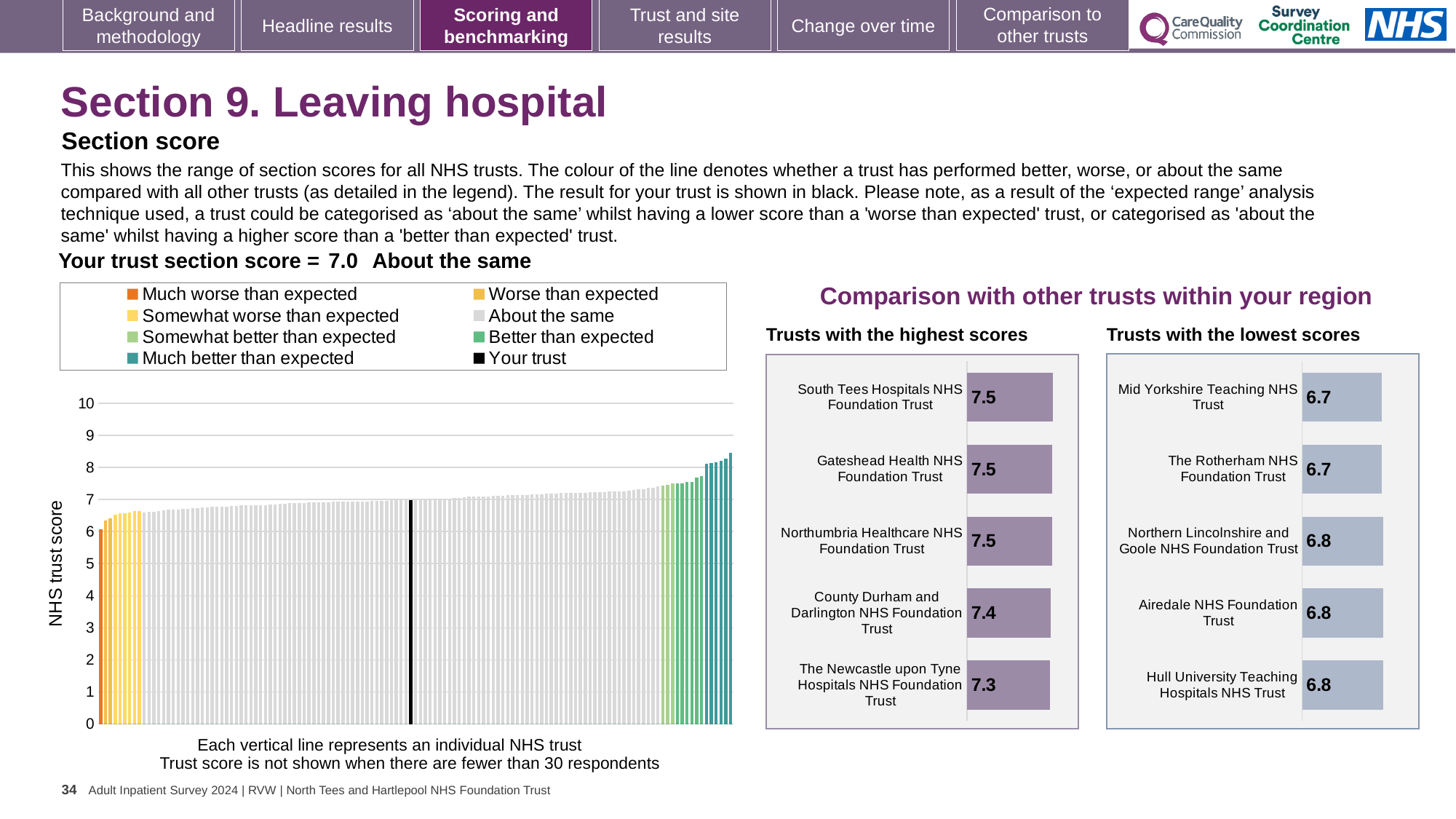
In the 'Trusts with the highest scores' chart, which trust has the lowest score? The Newcastle upon Tyne Hospitals NHS Foundation Trust In the 'Trusts with the lowest scores' chart, what is the score for Hull University Teaching Hospitals NHS Trust? 6.8 What kind of chart is the large chart on the left showing NHS trust scores? bar chart In the large chart on the left, is the value of the black bar (your trust) greater or less than 5? greater In the 'Trusts with the highest scores' chart, what is the score for South Tees Hospitals NHS Foundation Trust? 7.5 What is the label on the vertical axis of the large chart on the left? NHS trust score In the 'Trusts with the lowest scores' chart, what is the difference between the scores of Airedale NHS Foundation Trust and Mid Yorkshire Teaching NHS Trust? 0.1 In the 'Trusts with the highest scores' chart, which has the higher score: County Durham and Darlington NHS Foundation Trust or The Newcastle upon Tyne Hospitals NHS Foundation Trust? County Durham and Darlington NHS Foundation Trust In the large chart on the left, is the value of the tallest bar greater or less than 8? greater In the large chart on the left, how many entries does the legend list? 8 In the 'Trusts with the highest scores' chart, what is the difference between the scores of Gateshead Health NHS Foundation Trust and The Newcastle upon Tyne Hospitals NHS Foundation Trust? 0.2 In the 'Trusts with the highest scores' chart, how many trusts are shown? 5